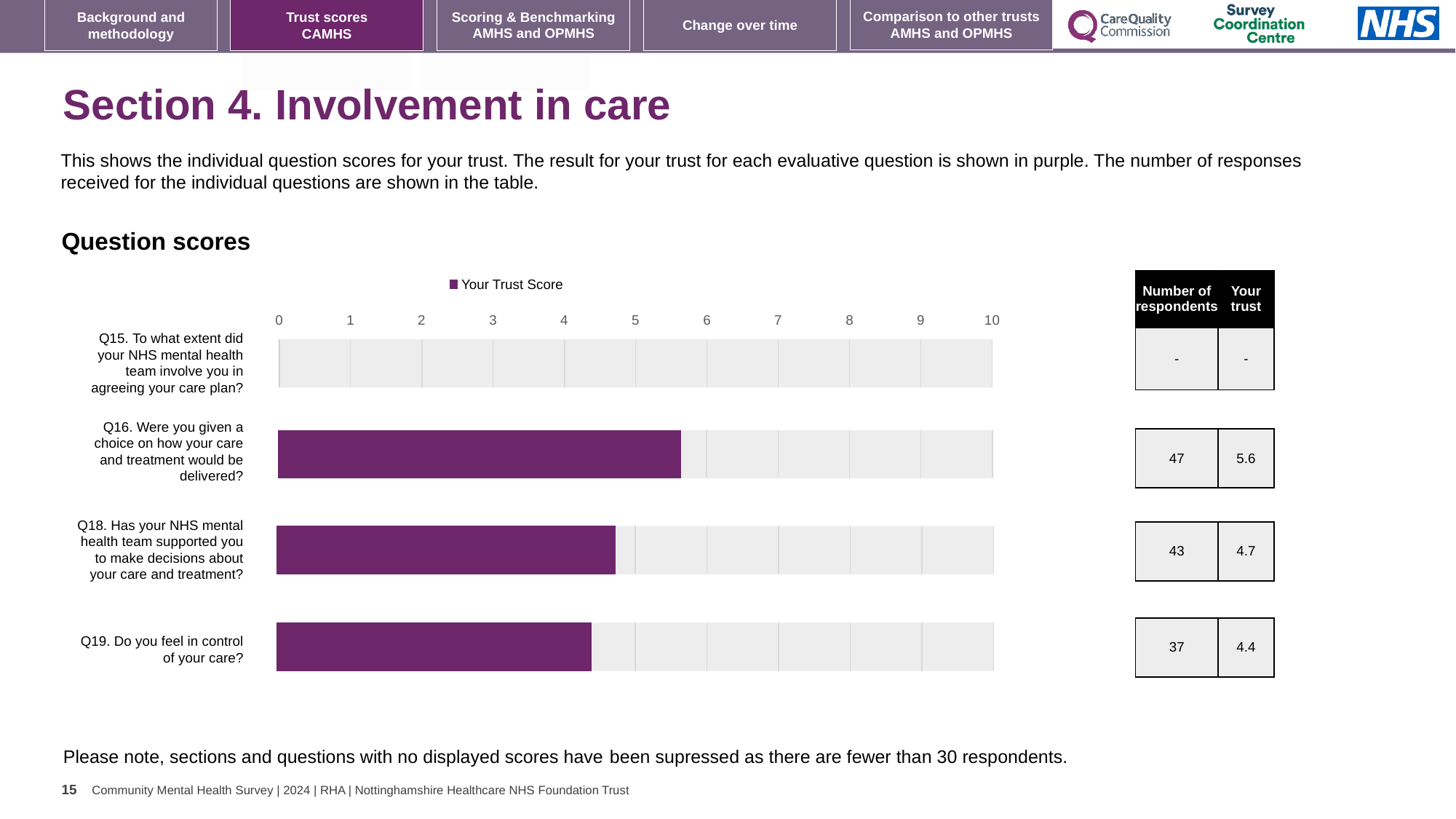
How many questions (categories) are listed on the Question scores chart? 4 What type of chart is shown under "Question scores"? bar chart Which has a larger trust score, Q18 or Q19? Q18 What is the name of the series shown in the legend of the Question scores chart? Your Trust Score What is the trust score for Q19 (Do you feel in control of your care?)? 4.4 How many series does the legend of the Question scores chart list? 1 Among the questions with a displayed score, which has the lowest trust score? Q19 Which question has the highest trust score on the Question scores chart? Q16 What is the trust score for Q18 (Has your NHS mental health team supported you to make decisions about your care and treatment?)? 4.7 What is the difference between the trust scores for Q16 and Q19? 1.2 Is the trust score for Q16 greater or less than 5? greater What is the trust score for Q16 (Were you given a choice on how your care and treatment would be delivered?)? 5.6